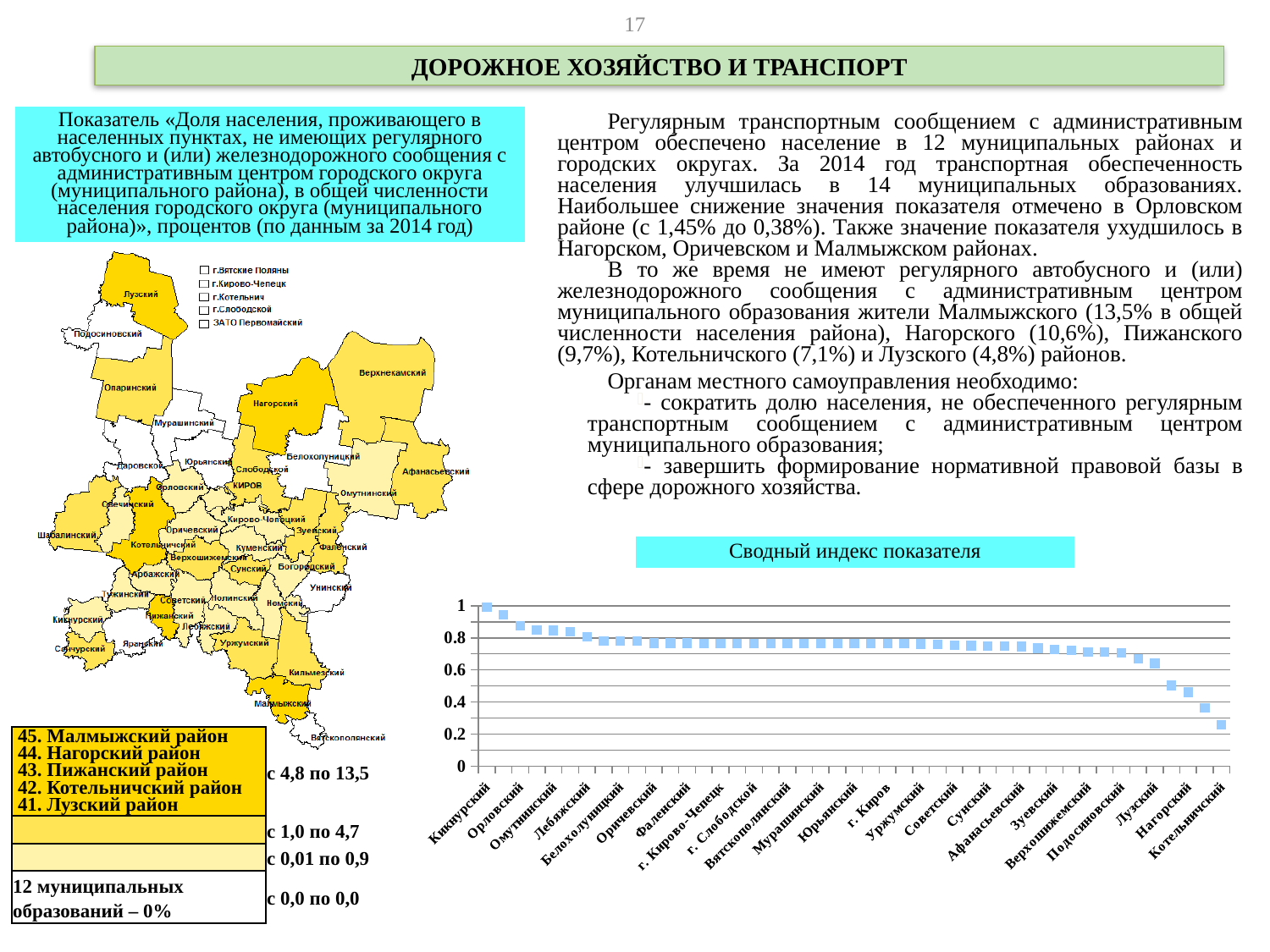
In the chart 'Сводный индекс показателя', what kind of chart is used to plot the values? scatter chart What is the title of the chart at the bottom right of the slide? Сводный индекс показателя In the chart 'Сводный индекс показателя', what is the highest value shown on the vertical axis? 1 In the chart 'Сводный индекс показателя', which has the larger value, г. Киров or Нагорский? г. Киров In the chart 'Сводный индекс показателя', do the values rise or fall from left to right along the x axis? fall In the chart 'Сводный индекс показателя', is the value for Орловский greater or less than 0.6? greater In the chart 'Сводный индекс показателя', is the value for Котельничский greater or less than 0.4? less In the chart 'Сводный индекс показателя', which has the larger value, Кикнурский or Котельничский? Кикнурский In the chart 'Сводный индекс показателя', is the value for Кикнурский greater or less than 0.8? greater In the chart 'Сводный индекс показателя', which category has the highest value? Кикнурский In the chart 'Сводный индекс показателя', which category has the lowest value? Котельничский